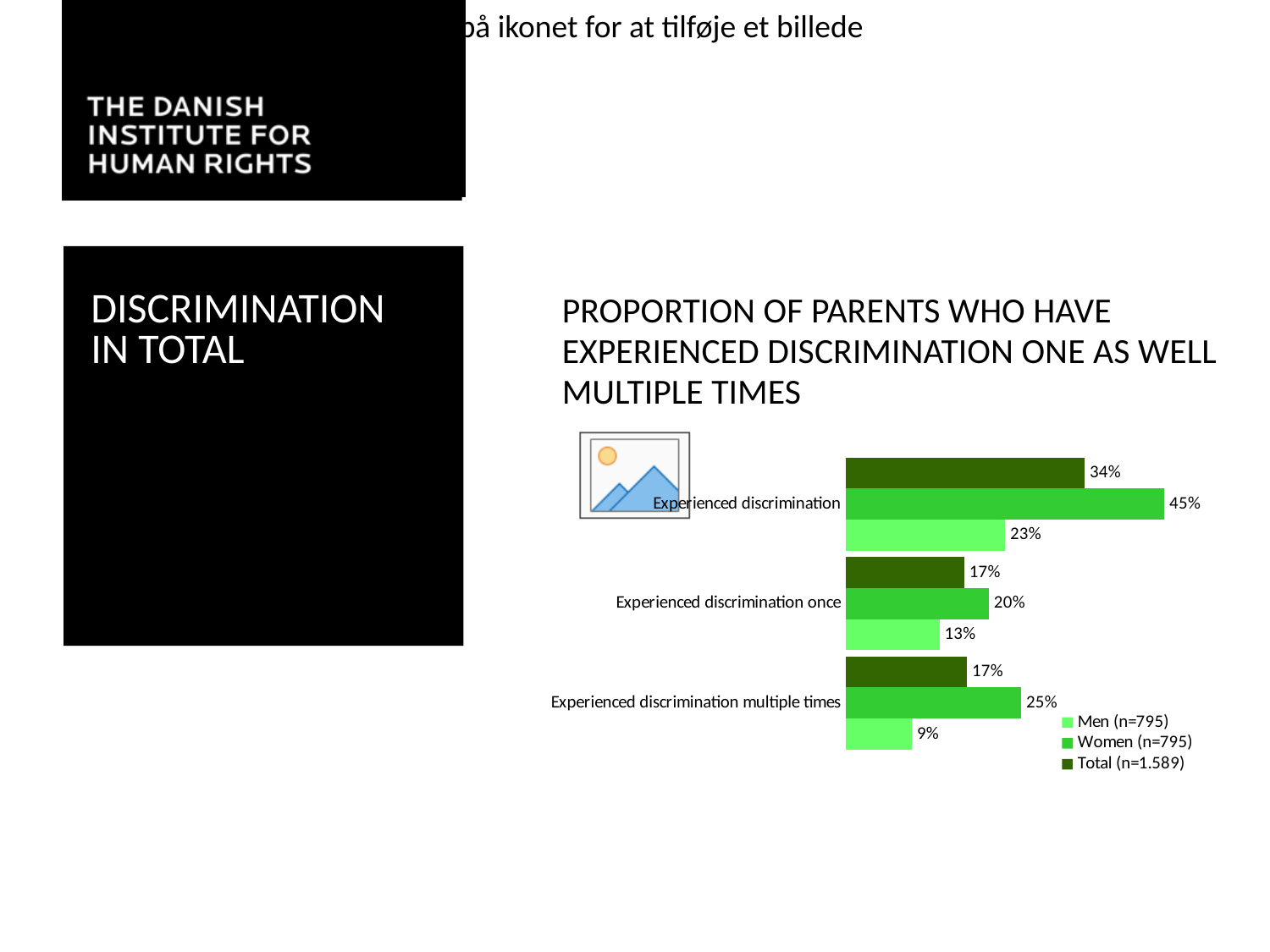
How many categories are shown on the chart? 3 How many series does the legend list? 3 What is the value for Women (n=795) in the 'Experienced discrimination' category? 45% What is the title of the chart? PROPORTION OF PARENTS WHO HAVE EXPERIENCED DISCRIMINATION ONE AS WELL MULTIPLE TIMES What is the value for Total (n=1.589) in the 'Experienced discrimination once' category? 17% Which is larger: the Women (n=795) value for 'Experienced discrimination once' or for 'Experienced discrimination multiple times'? Experienced discrimination multiple times What is the value for Men (n=795) in the 'Experienced discrimination multiple times' category? 9% What kind of chart is shown on the slide? bar chart What is the difference between the Women (n=795) and Men (n=795) values in the 'Experienced discrimination' category? 22% Which series has the lowest value in the 'Experienced discrimination multiple times' category? Men (n=795) Which series has the highest value in the 'Experienced discrimination' category? Women (n=795) What is the difference between the Total (n=1.589) value for 'Experienced discrimination' and for 'Experienced discrimination once'? 17%